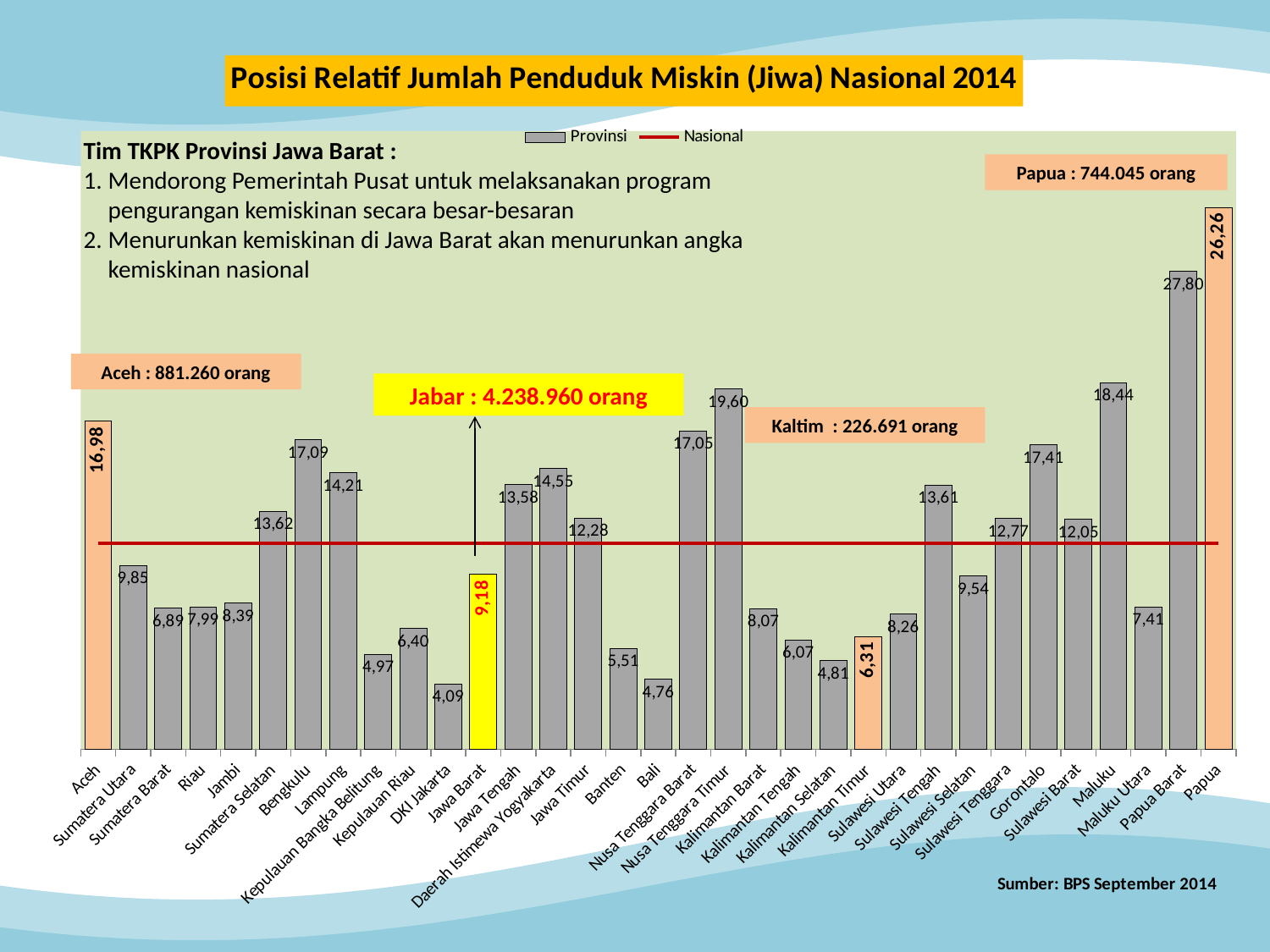
What is the difference between the values for Papua Barat and Papua? 1,54 What kind of chart is this? bar chart What is the value for Papua? 26,26 What is the value for Jawa Barat? 9,18 Which is larger, the value for Bengkulu or the value for Gorontalo? Gorontalo What is the value for Nusa Tenggara Timur? 19,60 How many provinces are shown on the x axis? 33 What does the red horizontal line represent according to the legend? Nasional Which province has the lowest value? DKI Jakarta What is the value for Kalimantan Timur? 6,31 What is the difference between the values for Aceh and Jawa Barat? 7,80